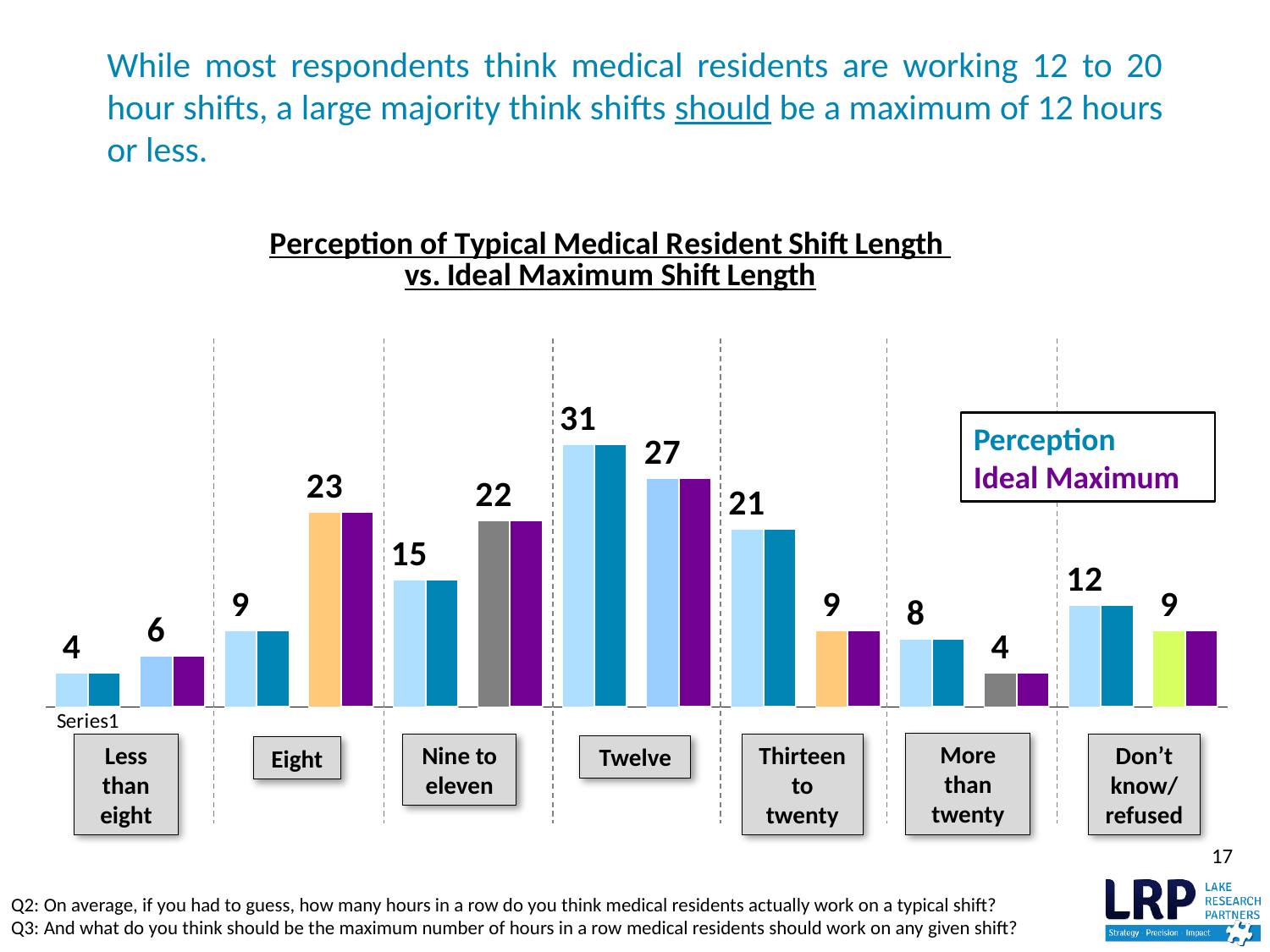
What is the Perception value for the Twelve category? 31 What is the title of the chart? Perception of Typical Medical Resident Shift Length vs. Ideal Maximum Shift Length What is the difference between the Perception and Ideal Maximum values for the Eight category? 14 What kind of chart is shown on the slide? Bar chart For the Thirteen to twenty category, which is larger: the Perception value or the Ideal Maximum value? Perception Which category has the highest Perception value? Twelve What is the Ideal Maximum value for the Eight category? 23 What is the Perception value for the Thirteen to twenty category? 21 How many series does the chart's legend list? 2 How many categories are shown on the x axis of the chart? 7 Which category has the lowest Perception value? Less than eight What is the Ideal Maximum value for the Nine to eleven category? 22